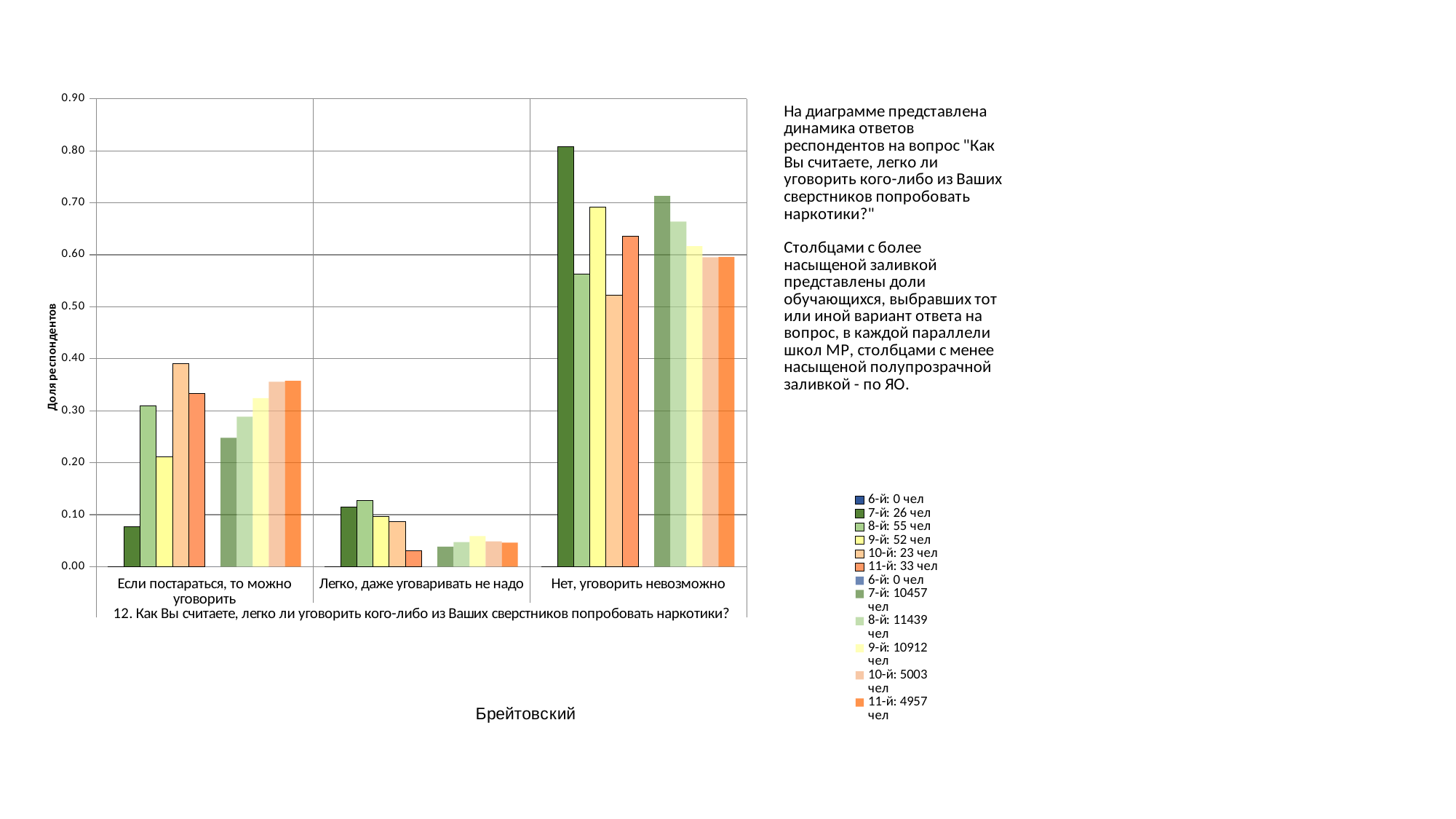
In the category "Если постараться, то можно уговорить", which is larger: the value for "7-й: 26 чел" or the value for "10-й: 23 чел"? 10-й: 23 чел Is the value for the "10-й: 23 чел" series in the category "Если постараться, то можно уговорить" greater or less than 0.30? greater In the category "Нет, уговорить невозможно", which is larger: the value for "7-й: 26 чел" or the value for "10-й: 23 чел"? 7-й: 26 чел What is the label of the chart's vertical axis? Доля респондентов Is the value for the "11-й: 33 чел" series in the category "Легко, даже уговаривать не надо" greater or less than 0.10? less Is the value for the "9-й: 52 чел" series in the category "Нет, уговорить невозможно" greater or less than 0.60? greater How many series does the chart's legend list? 12 Among the darker (MR) series, which has the highest value in the category "Нет, уговорить невозможно"? 7-й: 26 чел How many answer categories are shown along the x axis of the chart? 3 What kind of chart is shown on the slide? bar chart